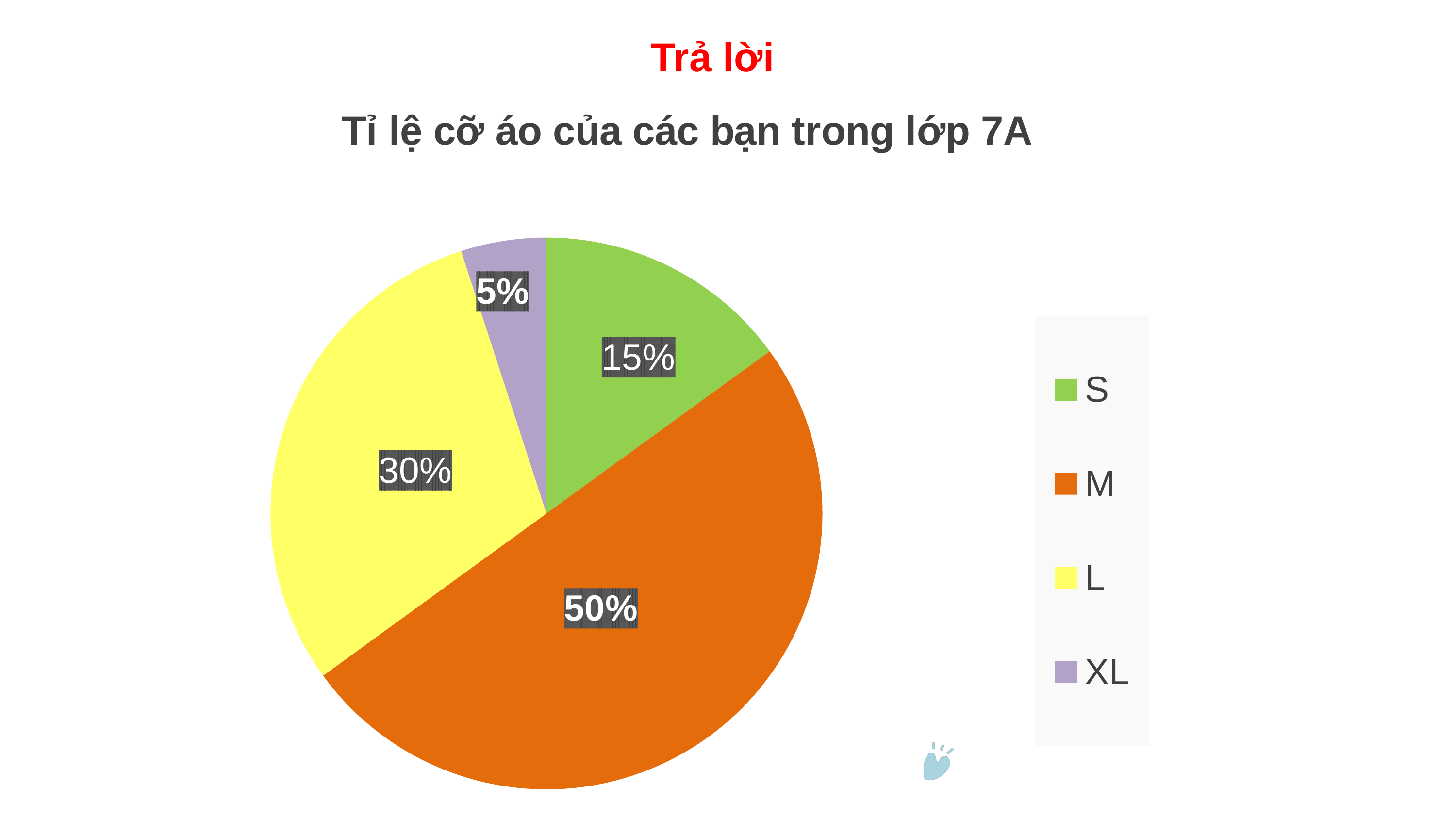
What is the title of the chart? Tỉ lệ cỡ áo của các bạn trong lớp 7A What percentage of the pie is the L slice? 30% What percentage of the pie is the S slice? 15% What percentage of the pie is the XL slice? 5% Which shirt size has the largest share of the pie? M How many slices does the pie chart have? 4 What percentage of the pie is the M slice? 50% What type of chart is shown on the slide? pie chart Which shirt size has the smallest share of the pie? XL Which is larger, the share for S or the share for XL? S What is the difference between the shares of L and S? 15% What colour is the L slice in the pie chart? yellow